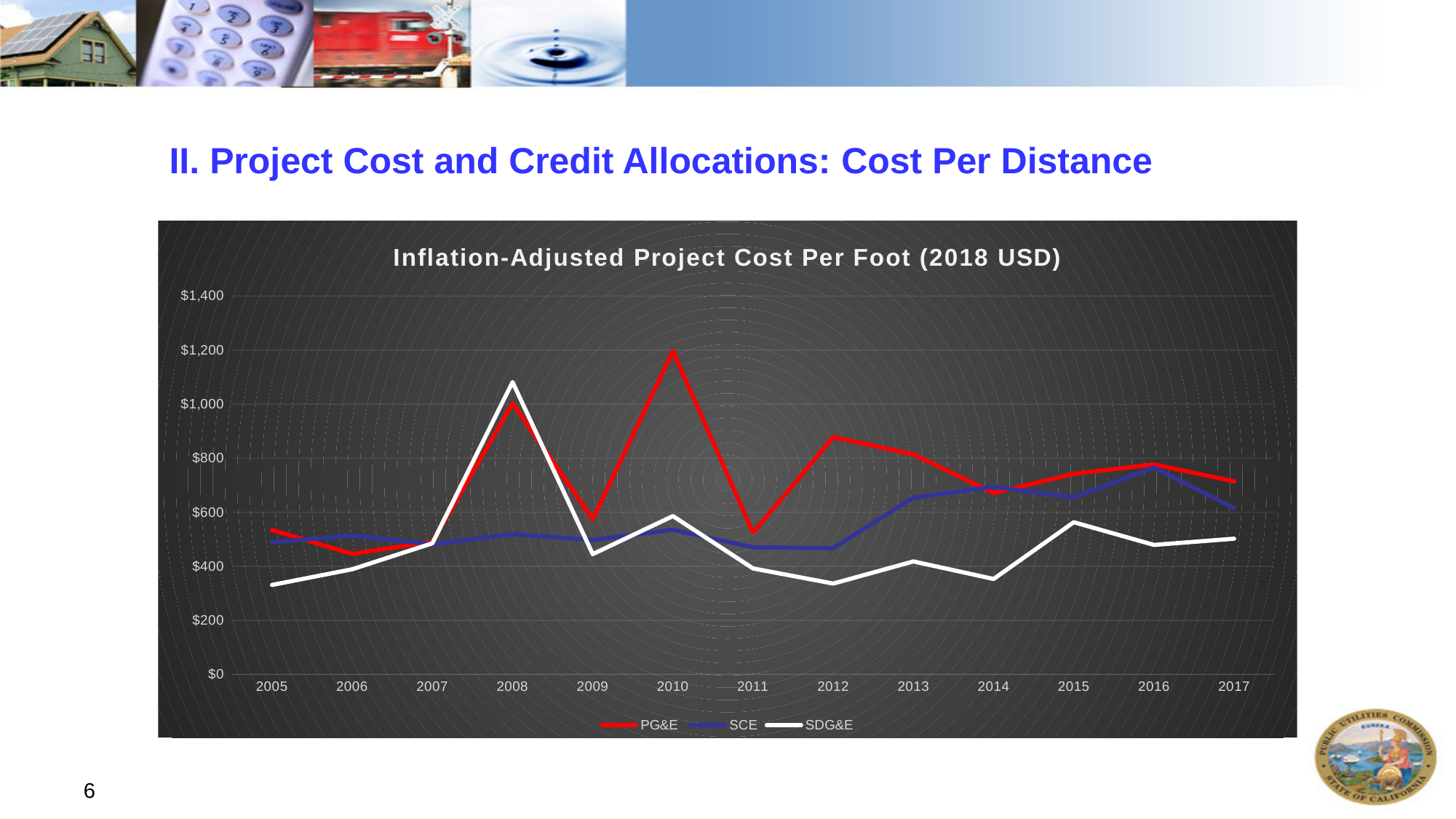
In 2008, which series has the higher value, PG&E or SDG&E? SDG&E What type of chart is shown on the slide? Line chart Is the PG&E value for 2010 greater or less than $1,000? greater What is the title of the chart? Inflation-Adjusted Project Cost Per Foot (2018 USD) Is the SDG&E value for 2005 greater or less than $400? less How many series does the legend list? 3 Does the SDG&E line rise or fall from 2005 to 2008? Rise How many years are shown on the x axis? 13 In which year does the PG&E line reach its highest value? 2010 In which year does the SDG&E line reach its highest value? 2008 Is the SCE value for 2011 greater or less than $600? less Which series is drawn in red? PG&E